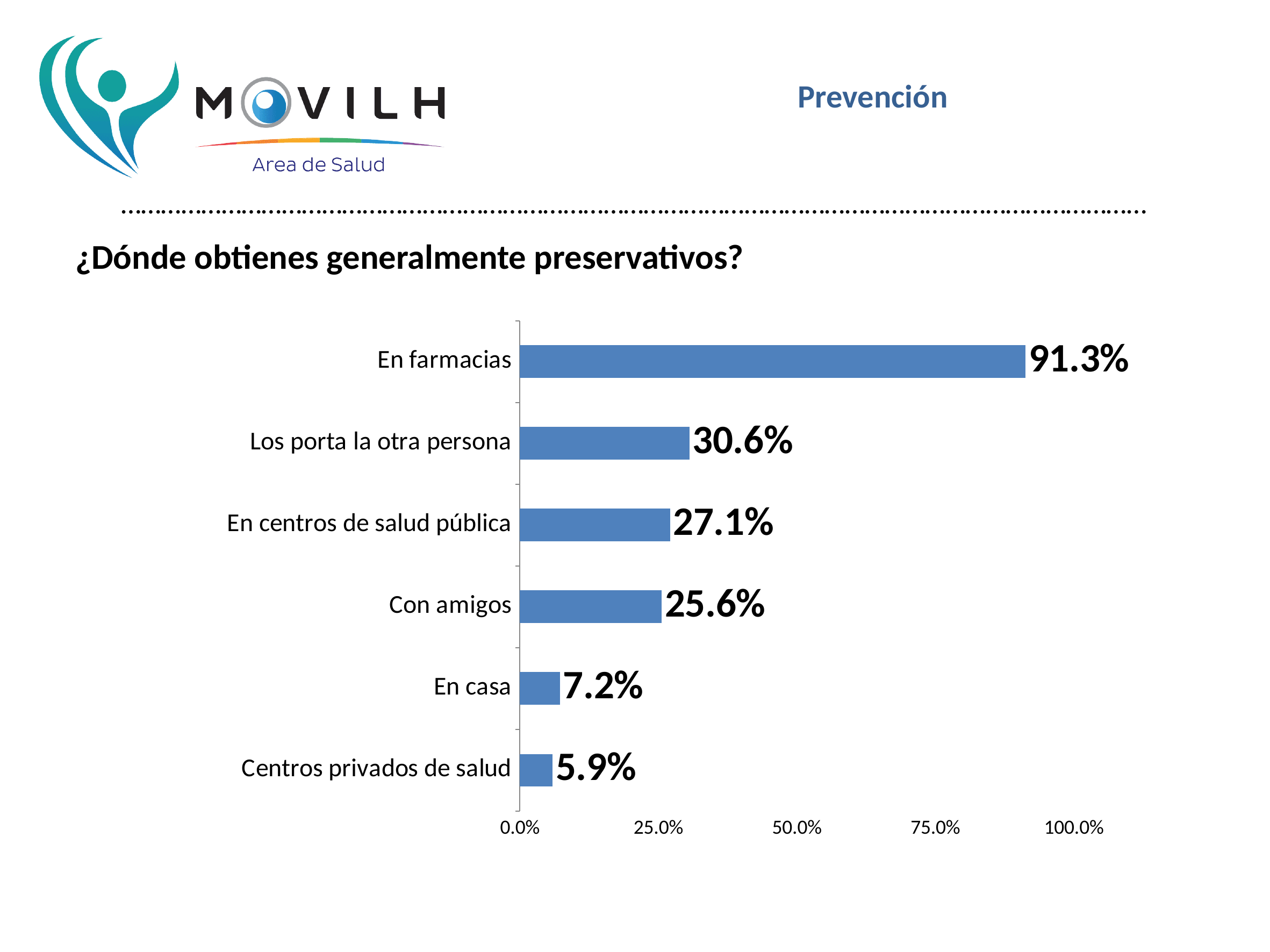
What is the value for 'Centros privados de salud'? 5.9% Which category has the highest value? En farmacias What is the difference between 'En farmacias' and 'Los porta la otra persona'? 60.7% What is the value for 'Con amigos'? 25.6% Which category has the lowest value? Centros privados de salud What is the difference between 'En centros de salud pública' and 'Con amigos'? 1.5% What kind of chart is shown on the slide? Bar chart What percentage of respondents obtain condoms 'En farmacias'? 91.3% What is the value for 'En casa'? 7.2% How many categories are shown in the chart? 6 Is the value for 'En farmacias' greater or less than 75.0%? greater Which is larger: 'Los porta la otra persona' or 'En centros de salud pública'? Los porta la otra persona